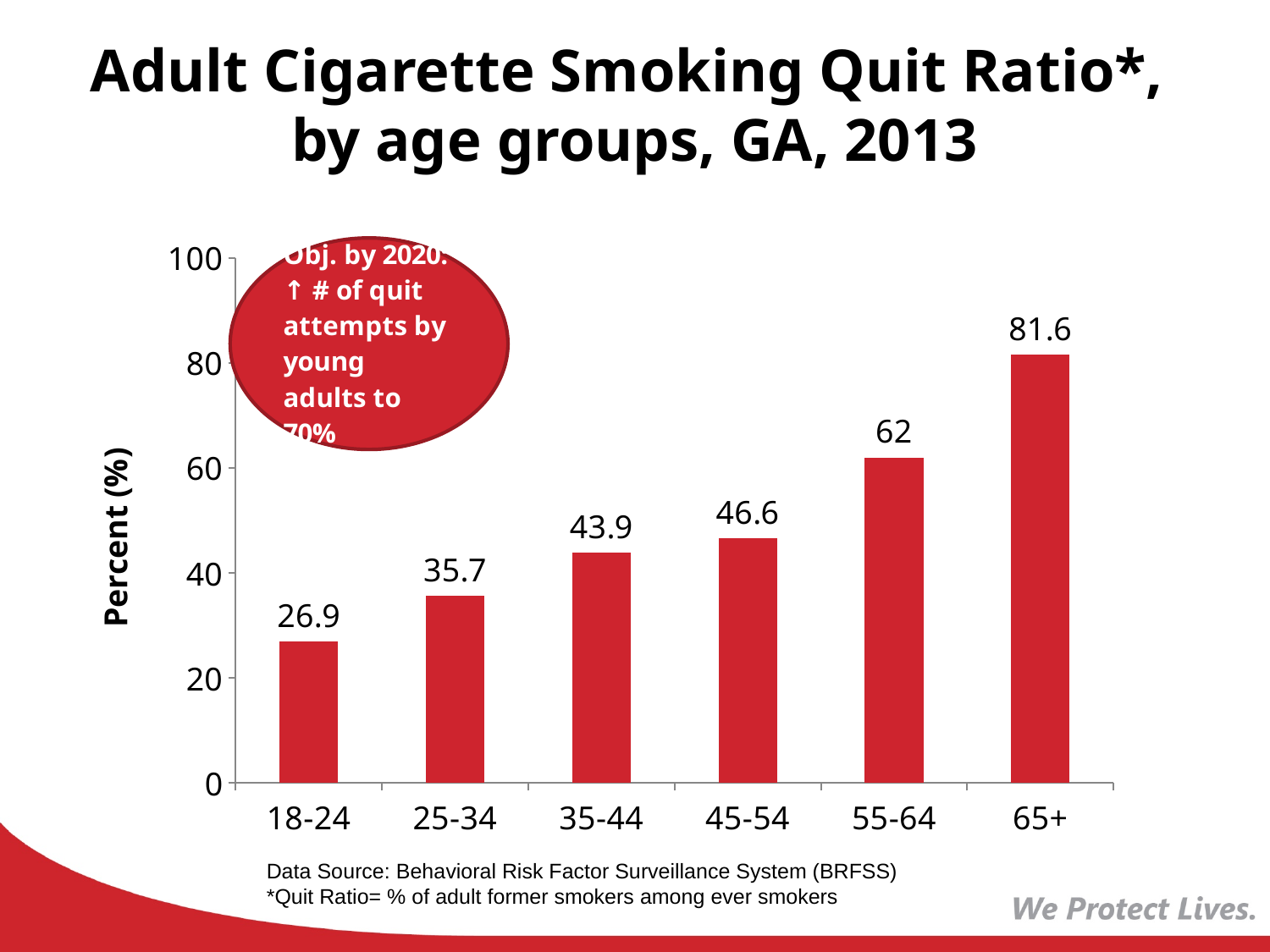
Which age group has the highest quit ratio? 65+ How many age groups are shown in the chart? 6 What type of chart is shown on the slide? bar chart Is the value for the 55-64 age group greater or less than 60? greater What is the quit ratio for the 55-64 age group? 62 What is the difference between the quit ratio for 45-54 and for 35-44? 2.7 Which age group has the lowest quit ratio? 18-24 What is the difference between the quit ratio for 65+ and for 18-24? 54.7 Which has a higher quit ratio, the 25-34 group or the 45-54 group? 45-54 What is the quit ratio for the 35-44 age group? 43.9 Do the quit ratio values rise or fall as age group increases along the x axis? rise What is the quit ratio for the 18-24 age group? 26.9